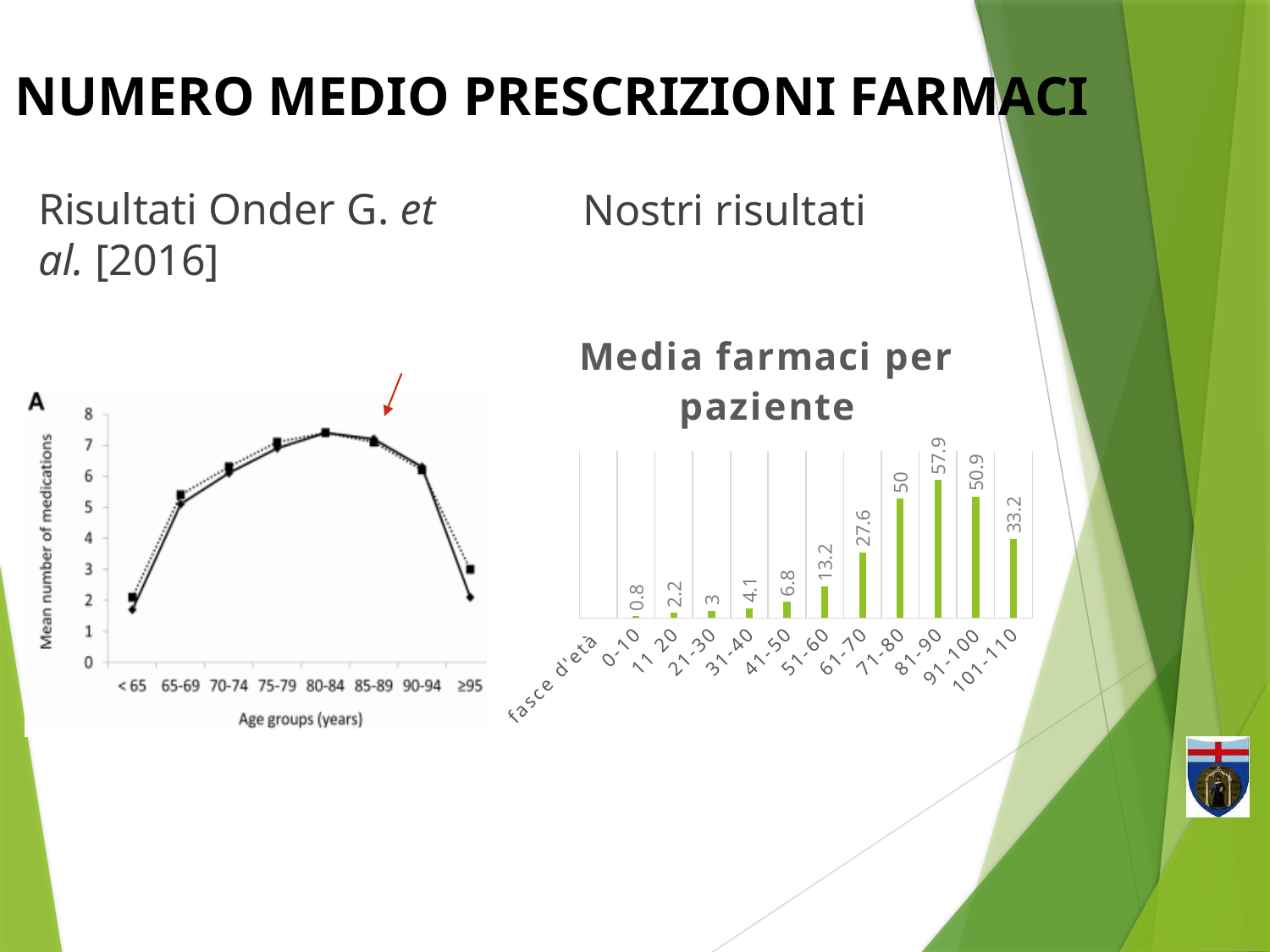
In the 'Media farmaci per paziente' chart, which age group has the highest value? 81-90 In the 'Media farmaci per paziente' chart, what is the value for the 0-10 age group? 0.8 In the 'Media farmaci per paziente' chart, which is larger: the value for 101-110 or the value for 61-70? 101-110 In the 'Media farmaci per paziente' chart, what is the value for the 81-90 age group? 57.9 In the 'Media farmaci per paziente' chart, what is the difference between the values for 91-100 and 71-80? 0.9 How many age groups are shown on the x axis of the left chart from Onder G. et al. [2016]? 8 In the left chart from Onder G. et al. [2016], is the mean number of medications for the 80-84 age group greater or less than 7? greater What kind of chart is the left chart from Onder G. et al. [2016]? Line chart In the 'Media farmaci per paziente' chart, which age group has the lowest value? 0-10 How many age-group bars are plotted in the 'Media farmaci per paziente' chart? 11 What kind of chart is the 'Media farmaci per paziente' chart? Bar chart In the 'Media farmaci per paziente' chart, what is the value for the 61-70 age group? 27.6